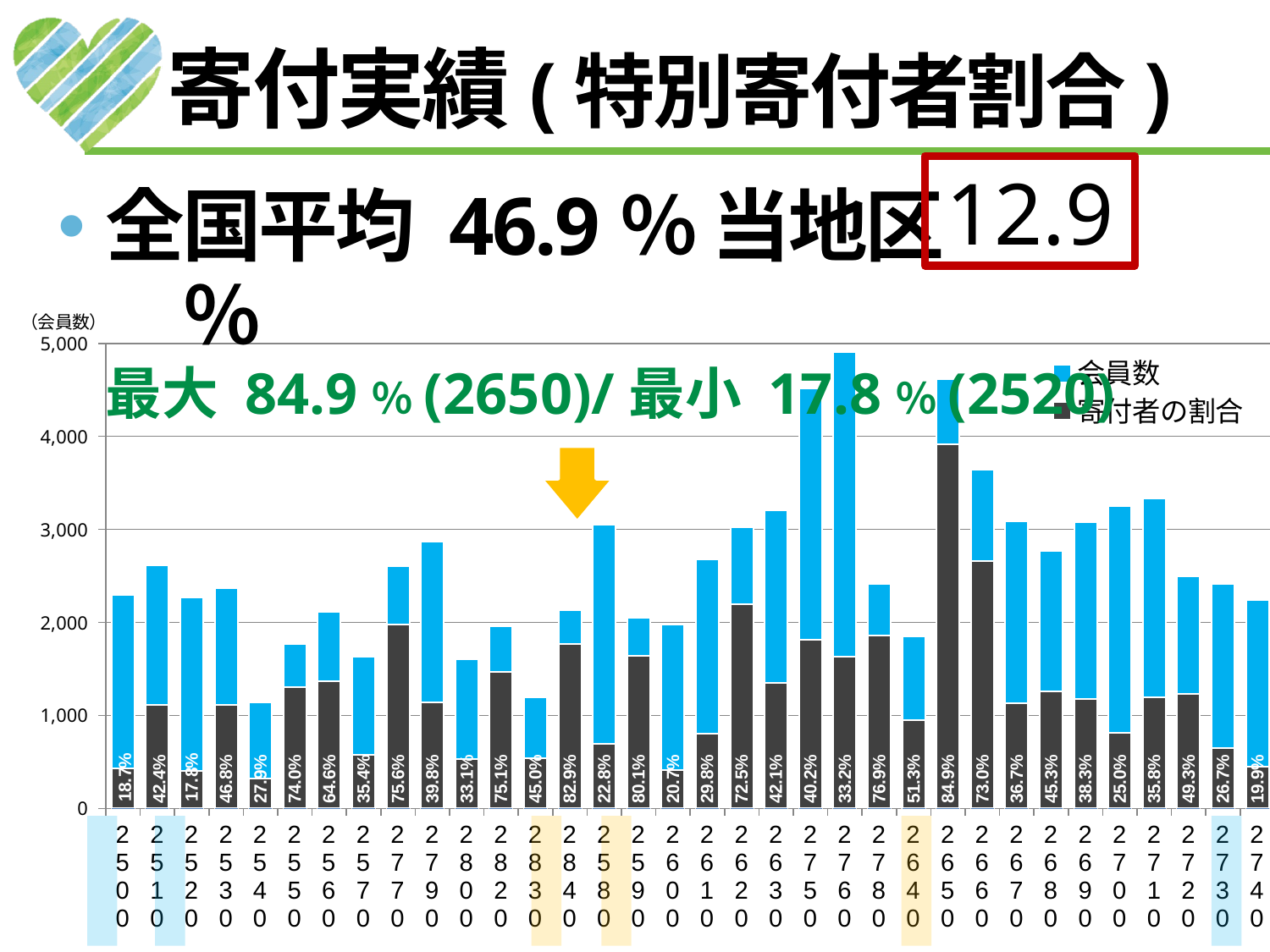
Which district has the lowest 寄付者の割合 label? 2520 What is the 寄付者の割合 label shown for district 2500? 18.7% What kind of chart is shown on the slide? bar chart What is the 寄付者の割合 label shown for district 2650? 84.9% Which district has the highest 寄付者の割合 label? 2650 How many series does the chart legend list? 2 Is the 会員数 value for district 2830 greater or less than 2,000? less What is the difference between the highest 寄付者の割合 label (district 2650) and the lowest (district 2520)? 67.1% What is the 寄付者の割合 label shown for district 2520? 17.8% Which district has the larger 寄付者の割合 label, 2840 or 2580? 2840 How many district categories are plotted along the x axis? 34 Is the 会員数 value for district 2760 greater or less than 4,000? greater